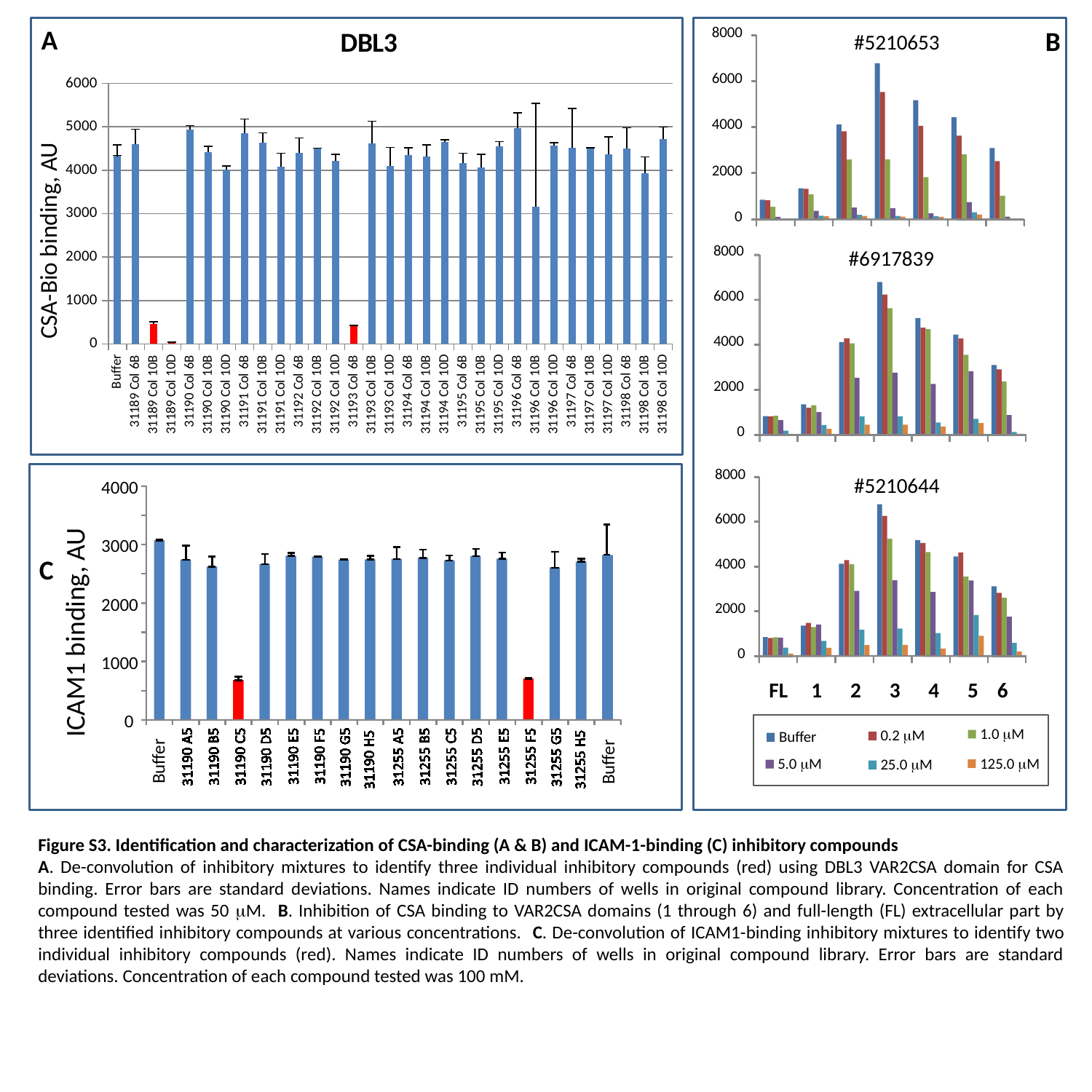
In the DBL3 chart (panel A), how many categories are shown on the x axis? 31 How many series does the legend in panel B list? 6 What kind of chart is the DBL3 chart in panel A? bar chart In the ICAM1 binding chart (panel C), is the value for 31190 C5 greater or less than 1000? less What is the y-axis title of the DBL3 chart in panel A? CSA-Bio binding, AU In the #5210653 chart (panel B), how many categories are shown on the x axis? 7 In the DBL3 chart (panel A), which is larger, the value for 31193 Col 6B or the value for 31193 Col 10B? 31193 Col 10B In the #5210653 chart (panel B), is the Buffer value for domain 3 greater or less than 6000? greater In the ICAM1 binding chart (panel C), how many categories are shown on the x axis? 18 In the DBL3 chart (panel A), is the value for 31189 Col 10B greater or less than 1000? less In the ICAM1 binding chart (panel C), which is larger, the value for 31255 F5 or the value for 31255 G5? 31255 G5 In the DBL3 chart (panel A), which category has the lowest CSA-Bio binding? 31189 Col 10D